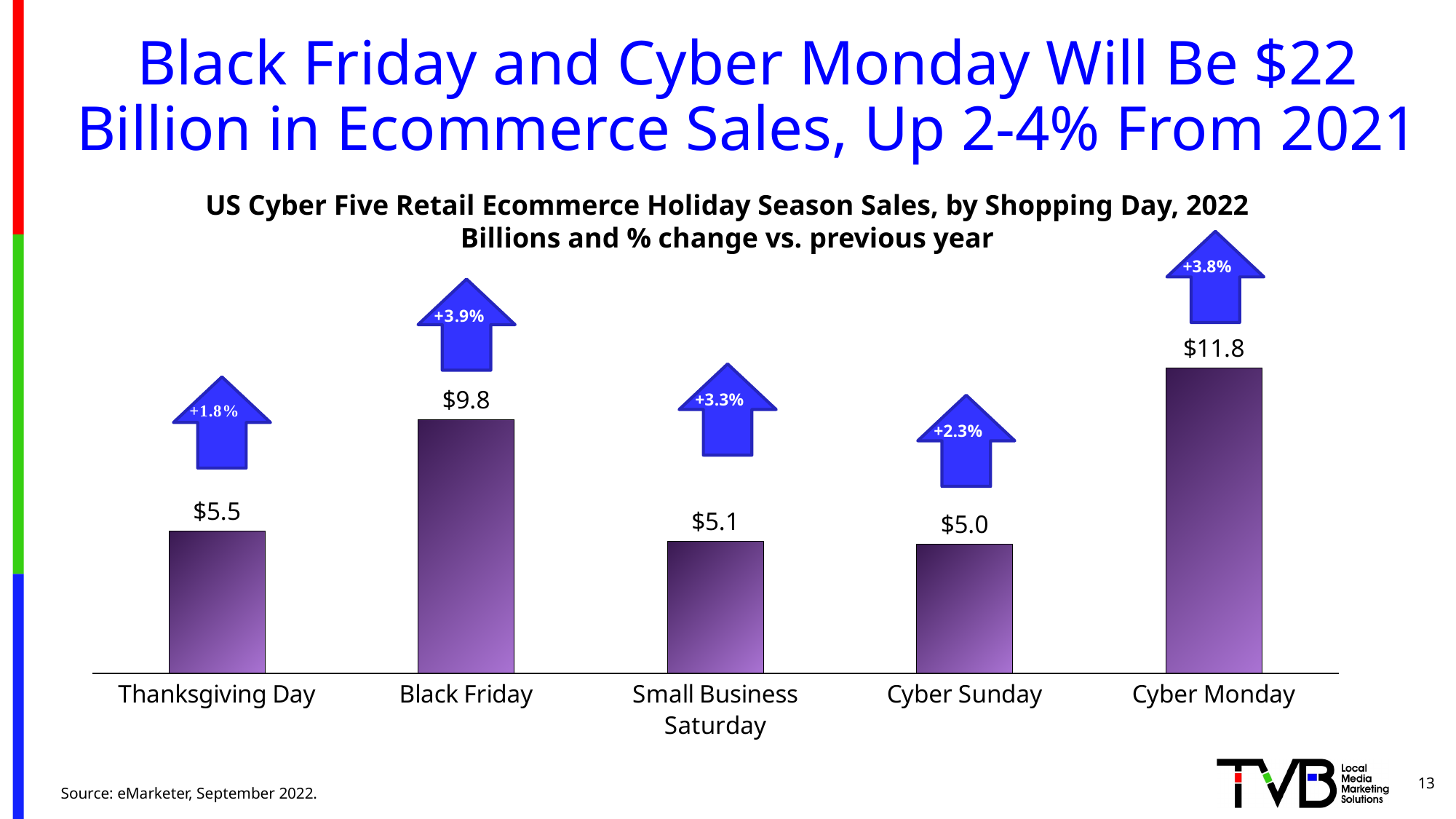
What kind of chart is this? bar chart What is the value for Black Friday? $9.8 How many shopping days are shown on the x axis? 5 What percentage change vs. the previous year is shown for Black Friday? +3.9% What is the value for Cyber Monday? $11.8 Which shopping day has the highest value? Cyber Monday Which is larger, the value for Thanksgiving Day or the value for Small Business Saturday? Thanksgiving Day Which shopping day has the lowest value? Cyber Sunday What is the value for Small Business Saturday? $5.1 What is the difference between the values for Cyber Monday and Black Friday? $2.0 What is the value for Thanksgiving Day? $5.5 What percentage change vs. the previous year is shown for Cyber Sunday? +2.3%